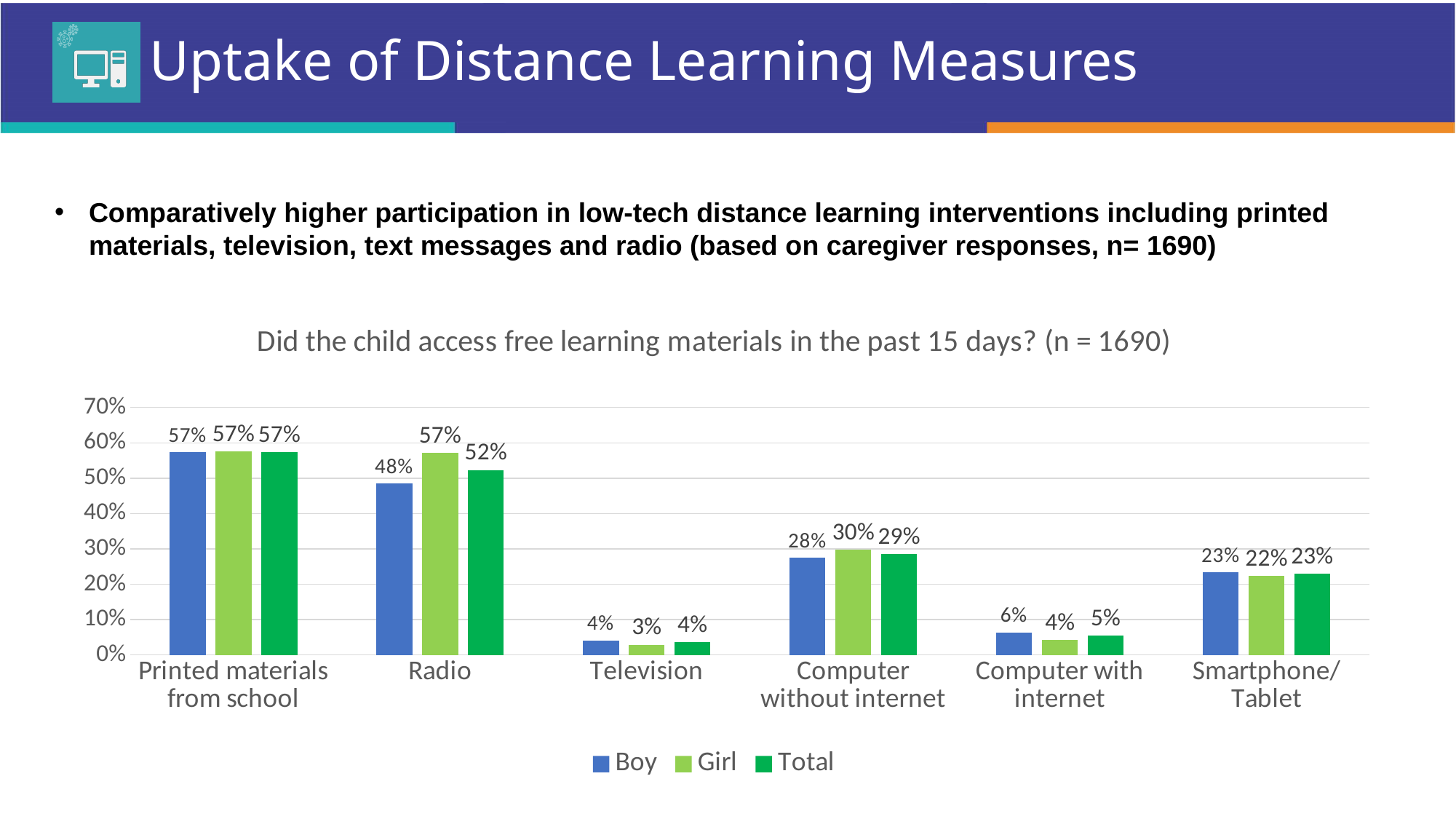
Which category has the lowest Total value? Television How many categories are shown on the x axis? 6 What is the Total value for Radio? 52% What is the Boy value for Computer with internet? 6% What kind of chart is shown on the slide? Bar chart Which is larger, the Total value for Computer without internet or the Total value for Smartphone/Tablet? Computer without internet What is the Girl value for Computer without internet? 30% How many series does the legend list? 3 What is the title of the chart? Did the child access free learning materials in the past 15 days? (n = 1690) Which category has the highest Boy value? Printed materials from school What is the difference between the Boy and Girl values for Radio? 9% What is the Girl value for Smartphone/Tablet? 22%